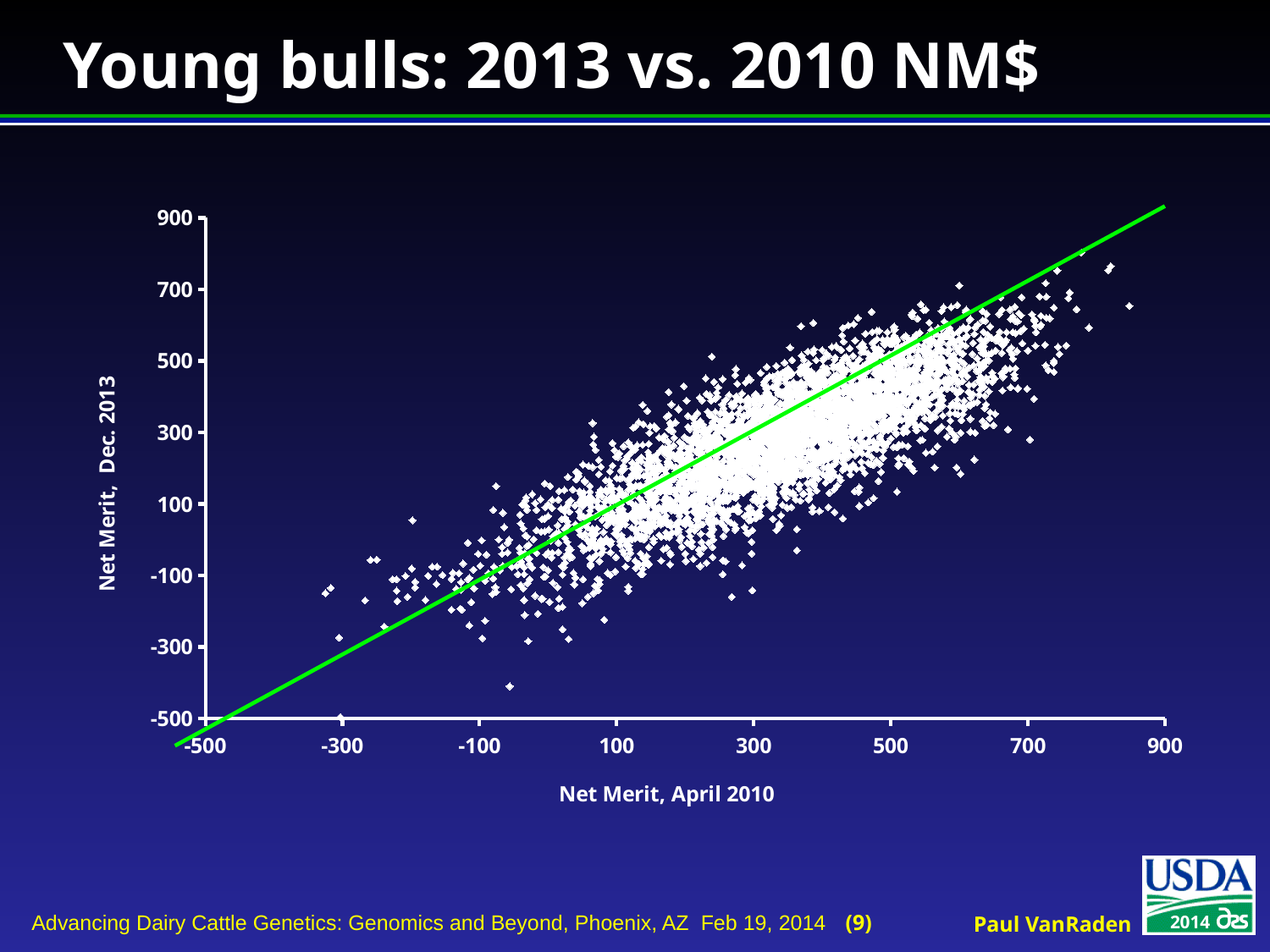
What is the label of the x axis? Net Merit, April 2010 What is the title of the chart? Young bulls: 2013 vs. 2010 NM$ What kind of chart is shown on the slide? scatter plot As Net Merit, April 2010 increases along the x axis, do the Net Merit, Dec. 2013 values generally rise or fall? rise